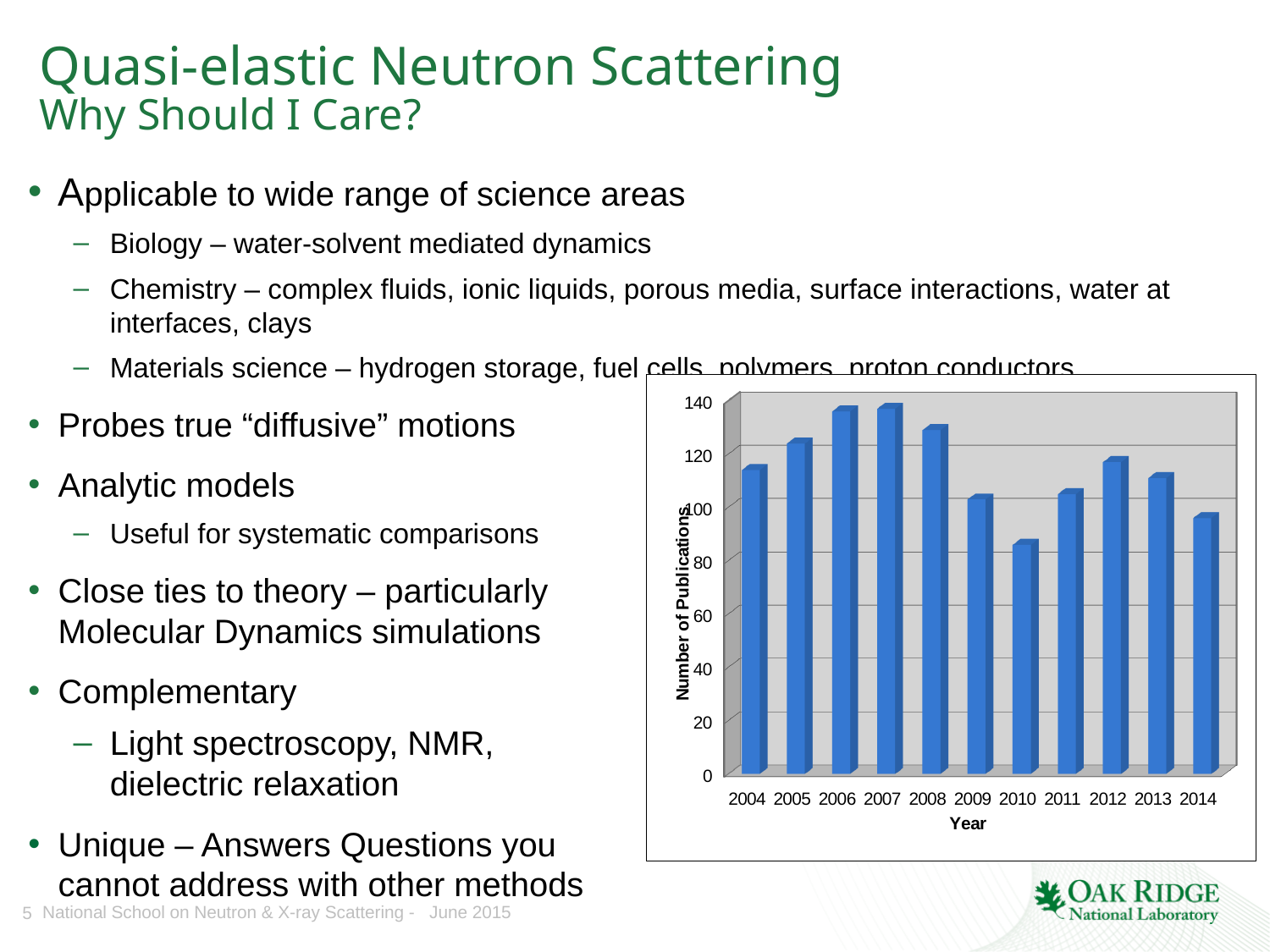
Which year has more publications, 2005 or 2010? 2005 Is the value for 2008 greater or less than 120? greater Is the value for 2014 greater or less than 100? less What is the label of the vertical axis of the chart? Number of Publications Is the value for 2006 greater or less than 120? greater Which year has more publications, 2008 or 2014? 2008 Which year has the lowest number of publications? 2010 How many years are shown on the x axis of the chart? 11 What kind of chart is shown on the slide? bar chart Do the values rise or fall from 2007 to 2010? fall